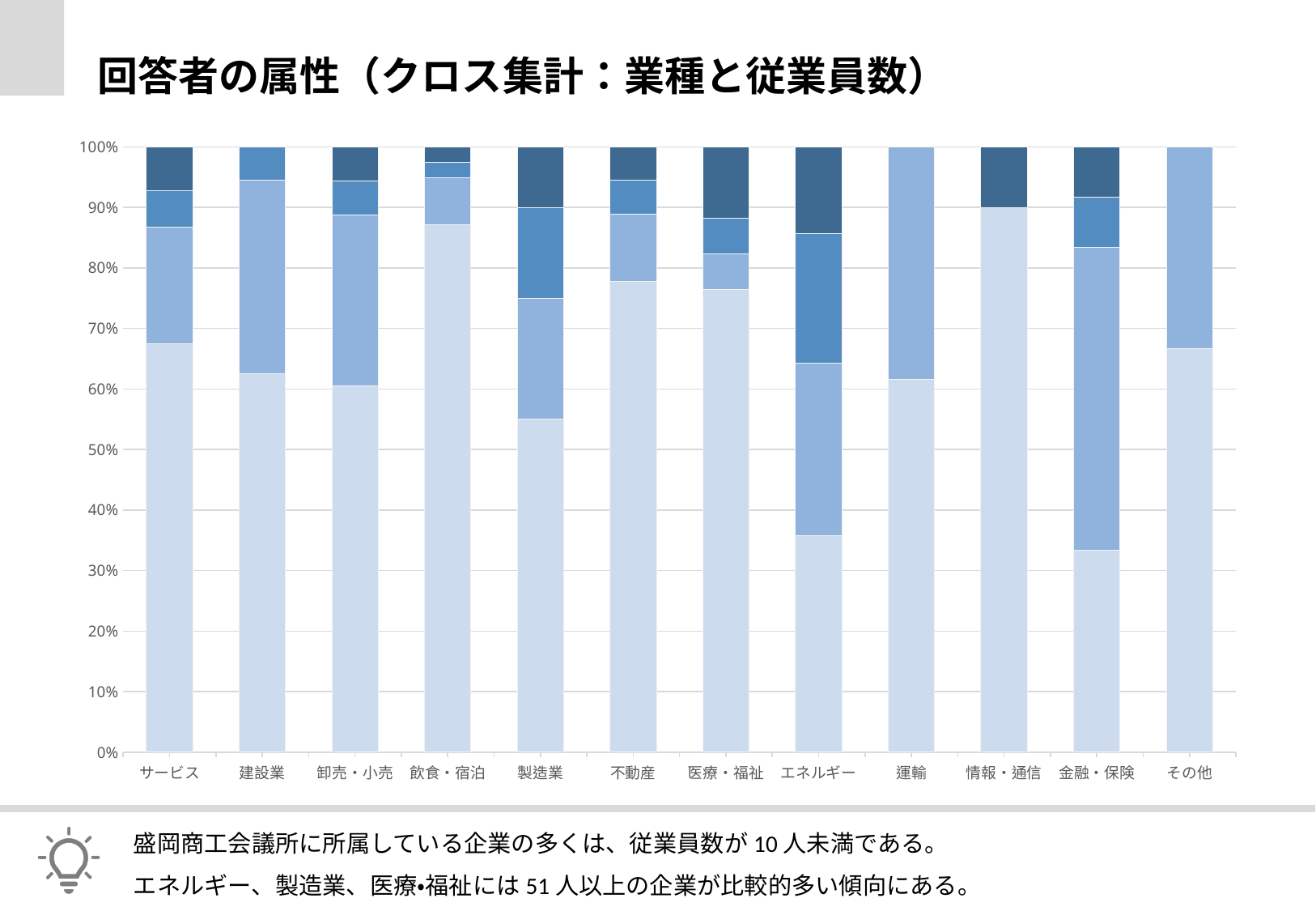
Which has the larger bottom (lightest) segment, サービス or エネルギー? サービス Is the bottom (lightest) segment for 情報・通信 greater or less than 80%? greater Is the bottom (lightest) segment for 製造業 greater or less than 50%? greater Is the bottom (lightest) segment for 金融・保険 greater or less than 40%? less How many industry categories are shown on the x axis? 12 What is the total height of the stacked bar for サービス? 100% What is the highest value shown on the y axis? 100% What is the title of the slide? 回答者の属性（クロス集計：業種と従業員数） Which industry has the smallest bottom (lightest) segment? 金融・保険 Which has the larger bottom (lightest) segment, 製造業 or 不動産? 不動産 What kind of chart is shown on the slide? stacked bar chart